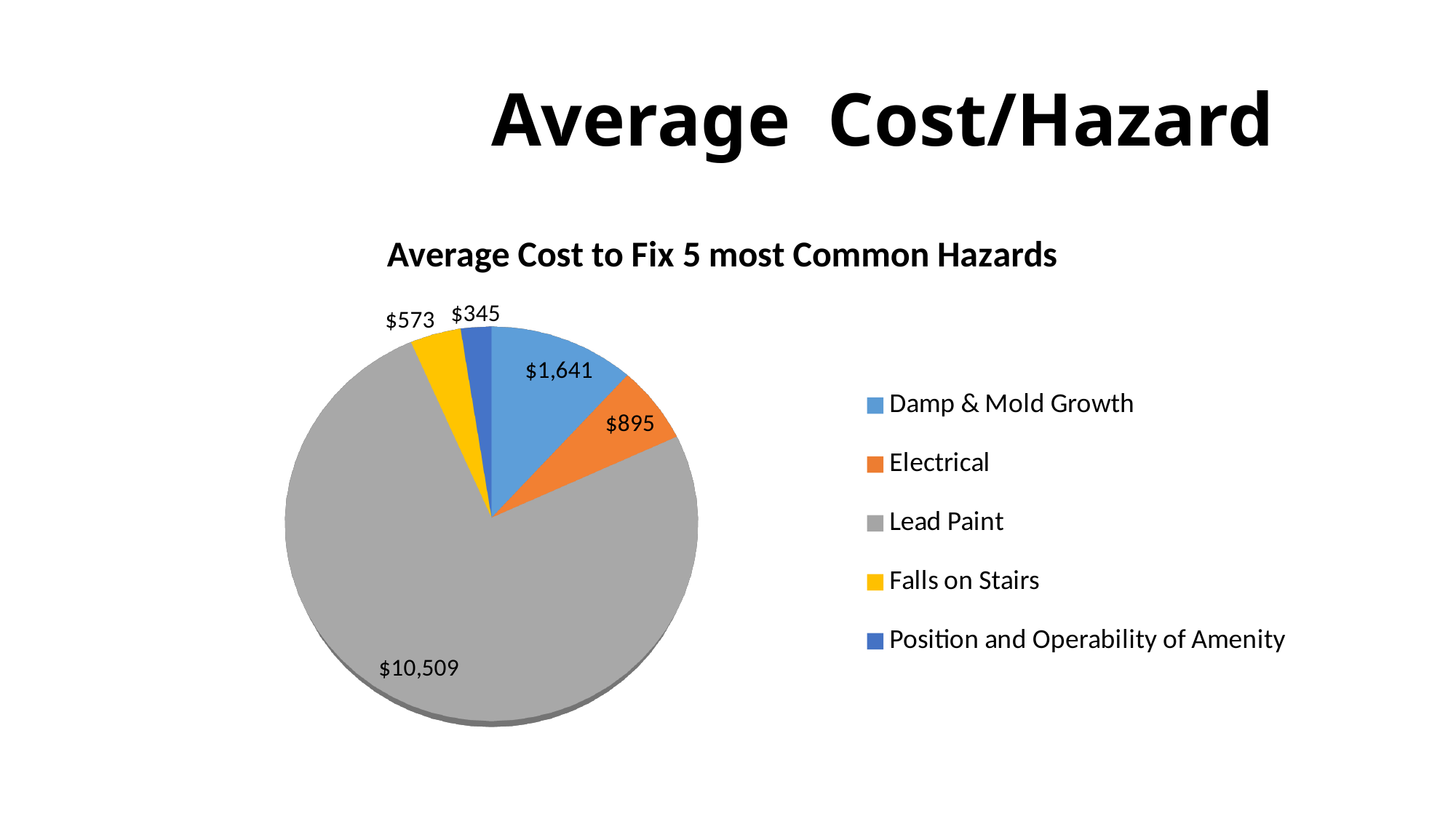
How many hazard categories are shown in the pie chart? 5 What is the difference in average cost between Damp & Mold Growth and Electrical hazards? $746 What is the average cost to fix Damp & Mold Growth hazards? $1,641 Which hazard has the highest average cost to fix? Lead Paint Which has a higher average cost to fix, Electrical or Falls on Stairs? Electrical What is the average cost to fix Falls on Stairs hazards? $573 What is the average cost to fix Electrical hazards? $895 What type of chart is shown on the slide? Pie chart How much more does it cost on average to fix Lead Paint than Damp & Mold Growth? $8,868 What is the average cost to fix Position and Operability of Amenity hazards? $345 What is the average cost to fix Lead Paint hazards? $10,509 Which hazard has the lowest average cost to fix? Position and Operability of Amenity